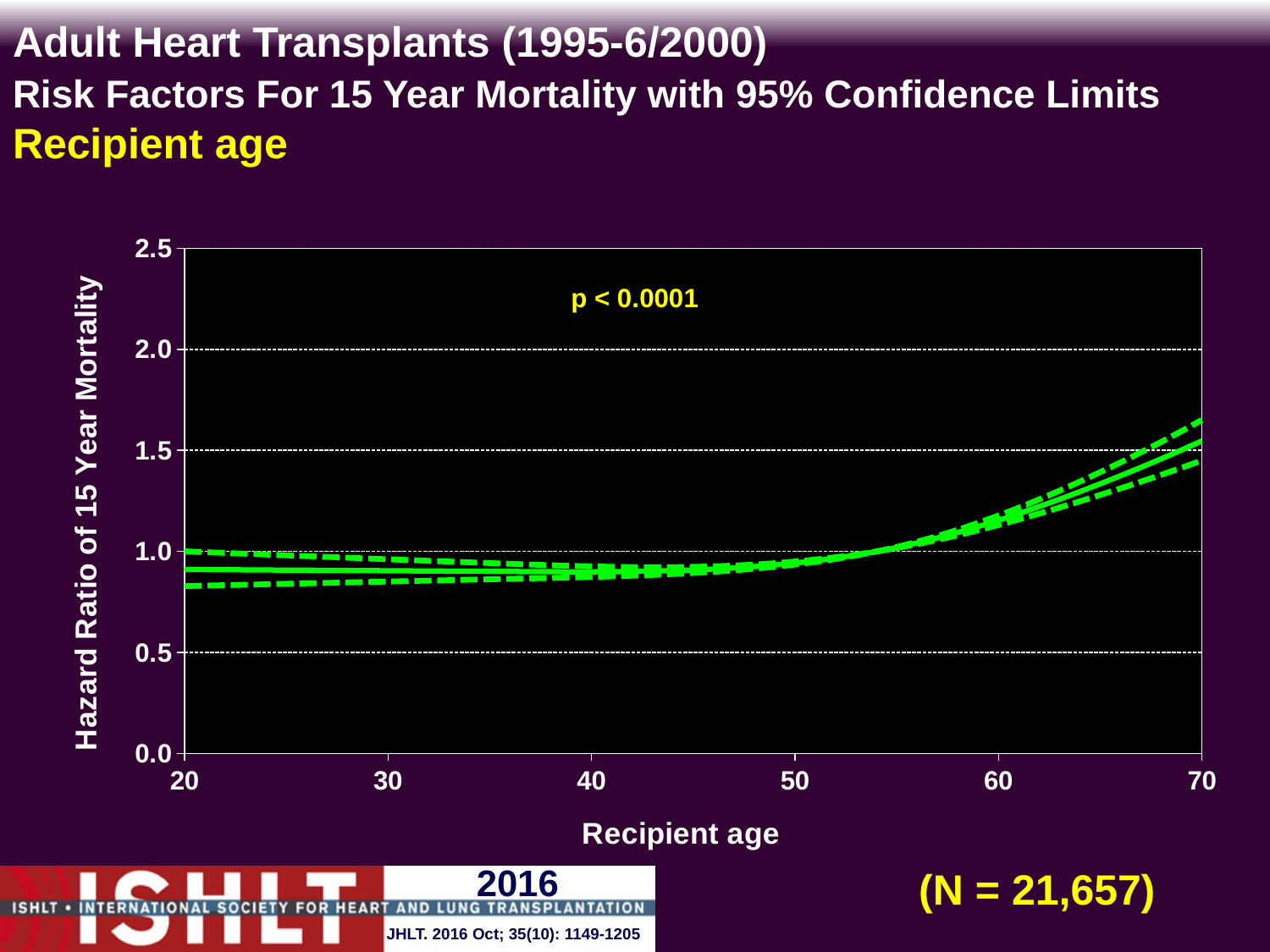
What is the lowest recipient age shown on the x axis? 20 What is the highest value shown on the y axis? 2.5 Is the hazard ratio for a recipient age of 60 greater or less than 1.0? greater What p-value is printed on the chart? p < 0.0001 Is the hazard ratio for a recipient age of 70 greater or less than 1.0? greater What sample size (N) is printed on the slide? N = 21,657 Is the hazard ratio for a recipient age of 40 greater or less than 1.0? less How many tick labels are shown on the x axis? 6 Does the hazard ratio rise or fall as recipient age increases from 50 to 70? rise What is the label of the x axis? Recipient age What kind of chart is shown on the slide? line chart